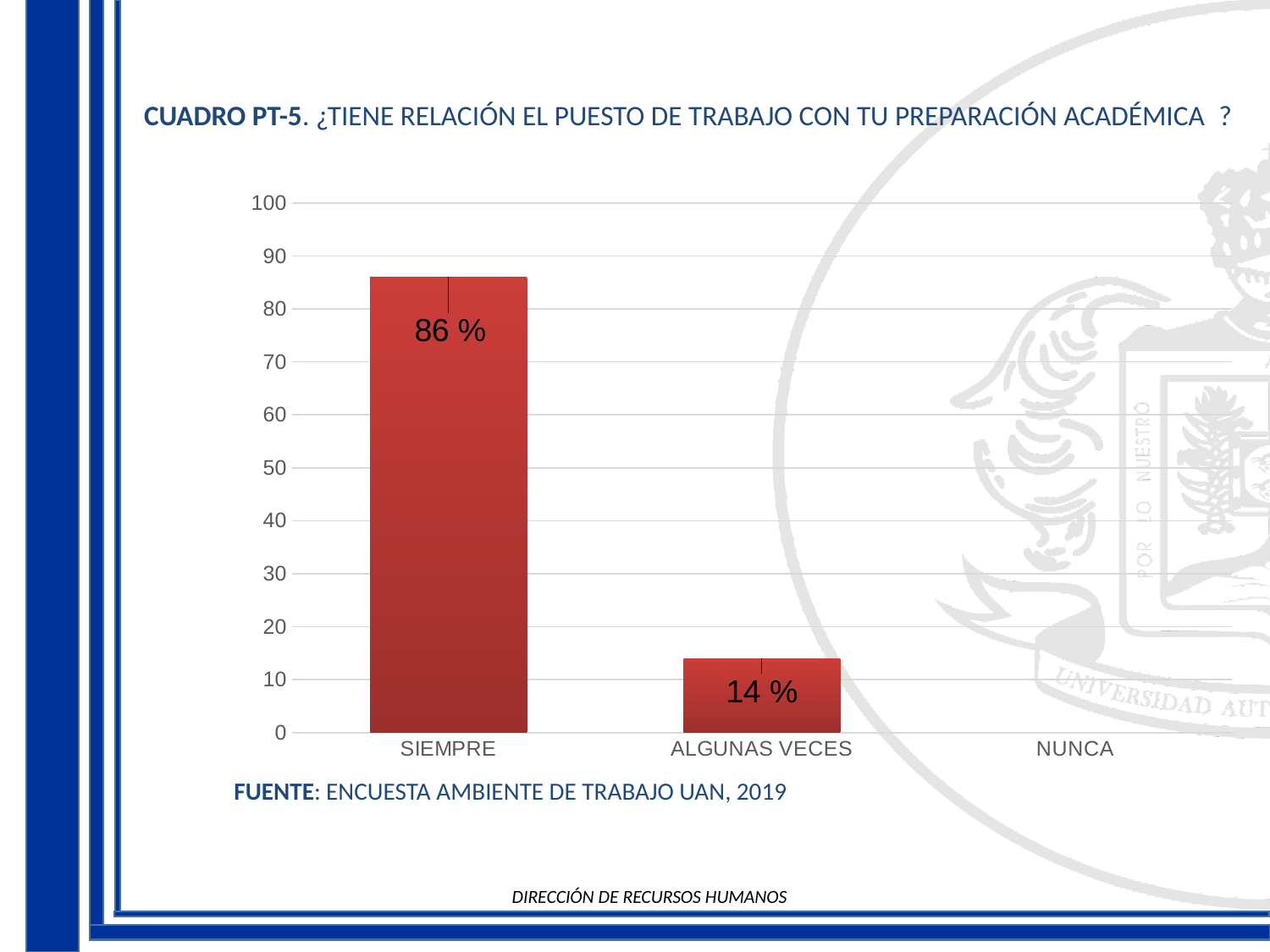
Is the value for SIEMPRE greater or less than 80? greater Which category has the highest value? SIEMPRE What is the source cited below the chart? ENCUESTA AMBIENTE DE TRABAJO UAN, 2019 What is the value for ALGUNAS VECES? 14 % What kind of chart is shown on the slide? Bar chart What is the difference between the values for SIEMPRE and ALGUNAS VECES? 72 % Which is larger, the value for SIEMPRE or the value for ALGUNAS VECES? SIEMPRE How many categories are shown on the x axis? 3 What is the value for SIEMPRE? 86 % Is the value for ALGUNAS VECES greater or less than 20? less Which category has the lowest value among those with a visible bar? ALGUNAS VECES What is the highest value shown on the y axis? 100